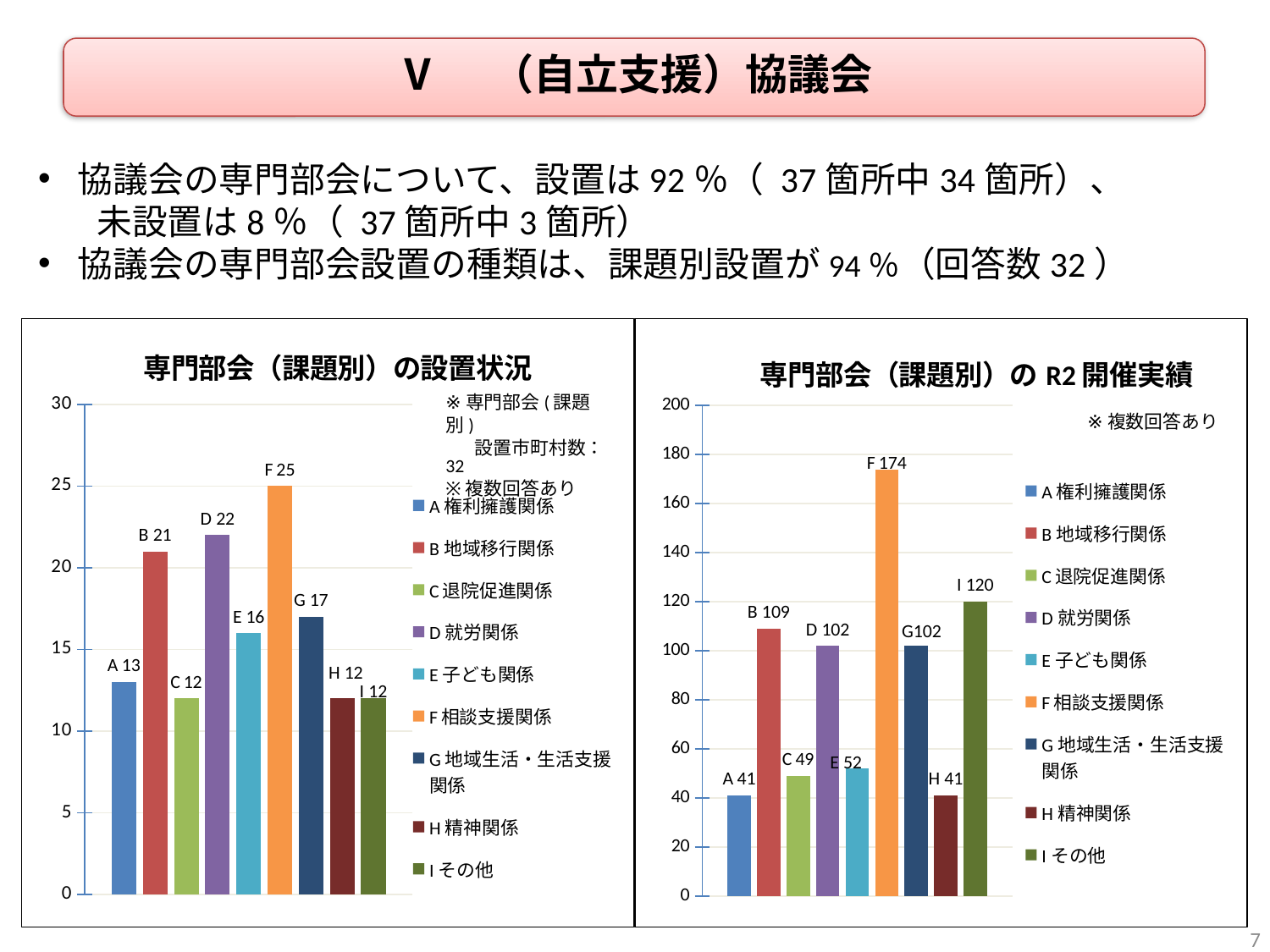
In the chart titled 専門部会（課題別）のR2開催実績, which is larger, the value for I その他 or the value for B 地域移行関係? I その他 In the chart titled 専門部会（課題別）の設置状況, what is the value for F 相談支援関係? 25 In the chart titled 専門部会（課題別）の設置状況, how many entries does the legend list? 9 In the chart titled 専門部会（課題別）のR2開催実績, which category has the highest value? F 相談支援関係 In the chart titled 専門部会（課題別）のR2開催実績, what is the value for F 相談支援関係? 174 In the chart titled 専門部会（課題別）の設置状況, how many categories are plotted? 9 In the chart titled 専門部会（課題別）の設置状況, what is the value for A 権利擁護関係? 13 In the chart titled 専門部会（課題別）の設置状況, what is the difference between the values for D 就労関係 and B 地域移行関係? 1 In the chart titled 専門部会（課題別）の設置状況, which category has the highest value? F 相談支援関係 In the chart titled 専門部会（課題別）のR2開催実績, what is the difference between the values for F 相談支援関係 and I その他? 54 What kind of chart is the chart titled 専門部会（課題別）のR2開催実績? Bar chart In the chart titled 専門部会（課題別）のR2開催実績, what is the value for C 退院促進関係? 49